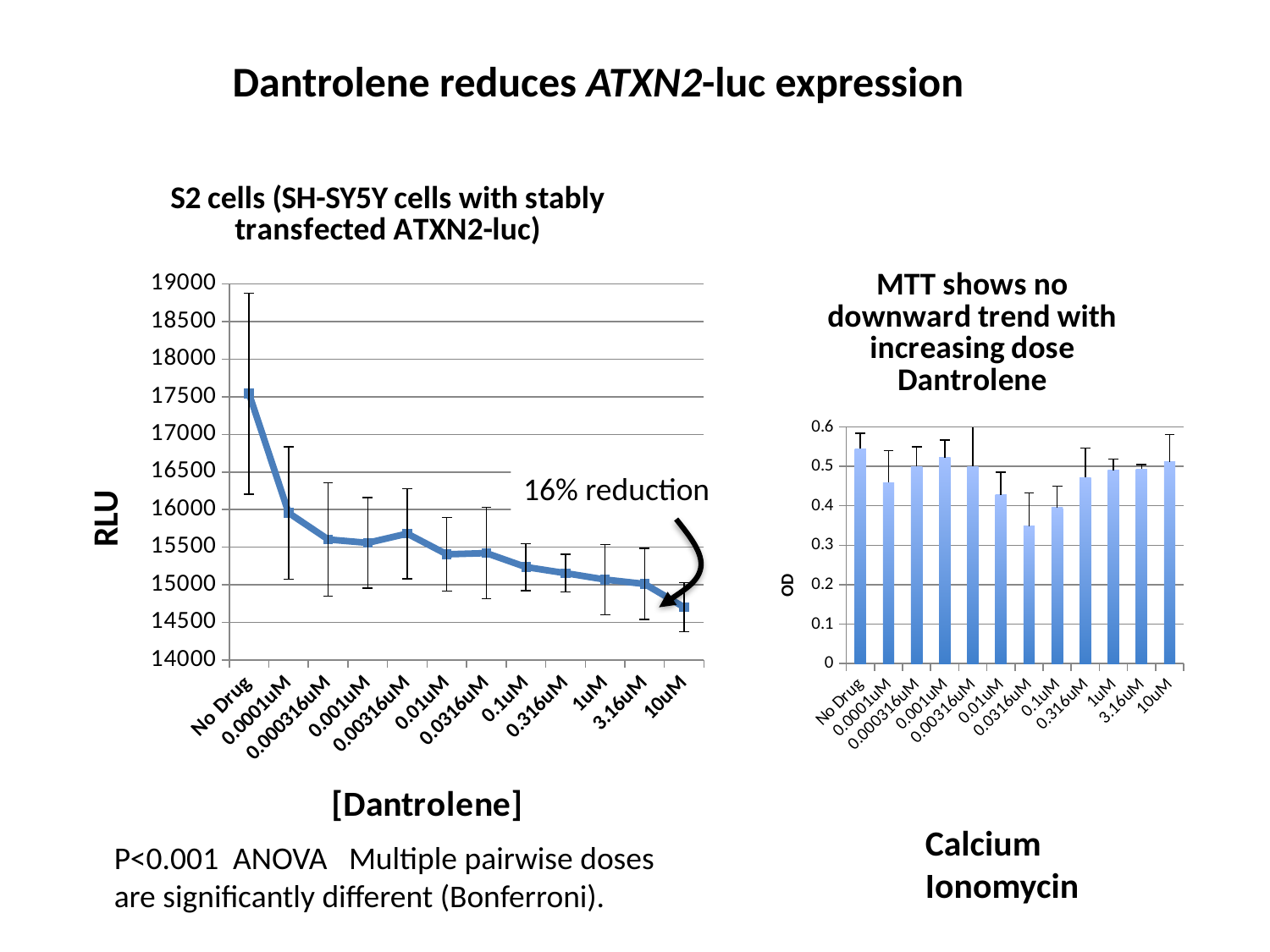
On the left chart (S2 cells), which category has the highest RLU value? No Drug On the left chart (S2 cells), is the value for No Drug greater or less than 17000? greater On the left chart (S2 cells), do the RLU values generally rise or fall as the Dantrolene concentration increases along the x axis? fall On the left chart (S2 cells), is the value for 0.0001uM greater or less than 16500? less On the right chart (MTT), which category has the lowest OD value? 0.0316uM What kind of chart is the right chart (MTT)? bar chart What is the y-axis label of the left chart (S2 cells)? RLU What kind of chart is the left chart (S2 cells)? line chart On the right chart (MTT), is the value for 0.0316uM greater or less than 0.4? less How many categories are plotted on the left chart (S2 cells)? 12 On the left chart (S2 cells), which category has the lowest RLU value? 10uM